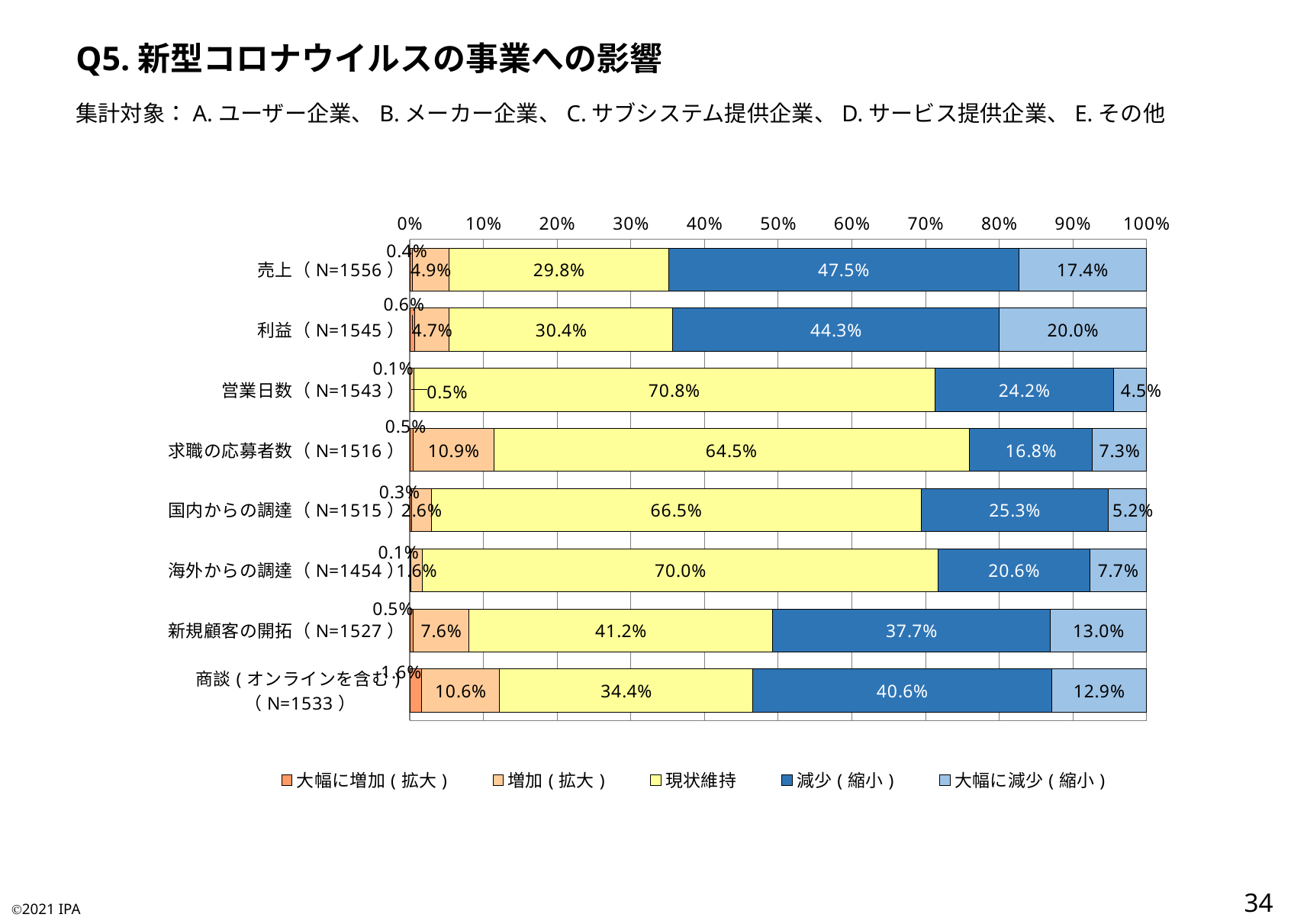
What is the value of 大幅に減少（縮小） for 利益（N=1545）? 20.0% How many categories are shown on the chart? 8 How many series does the legend list? 5 What is the difference between the 減少（縮小） values for 売上（N=1556） and 利益（N=1545）? 3.2 percentage points What is the value of 現状維持 for 営業日数（N=1543）? 70.8% Which category has the lowest value for 大幅に減少（縮小）? 営業日数（N=1543） Which legend entry is shown in yellow? 現状維持 What is the value of 増加（拡大） for 求職の応募者数（N=1516）? 10.9% Which category has the highest value for 現状維持? 営業日数（N=1543） What is the value of 減少（縮小） for 売上（N=1556）? 47.5% Which is larger: the 現状維持 value for 新規顧客の開拓（N=1527） or for 商談（オンラインを含む）（N=1533）? 新規顧客の開拓（N=1527） What kind of chart is shown on the slide? Stacked bar chart